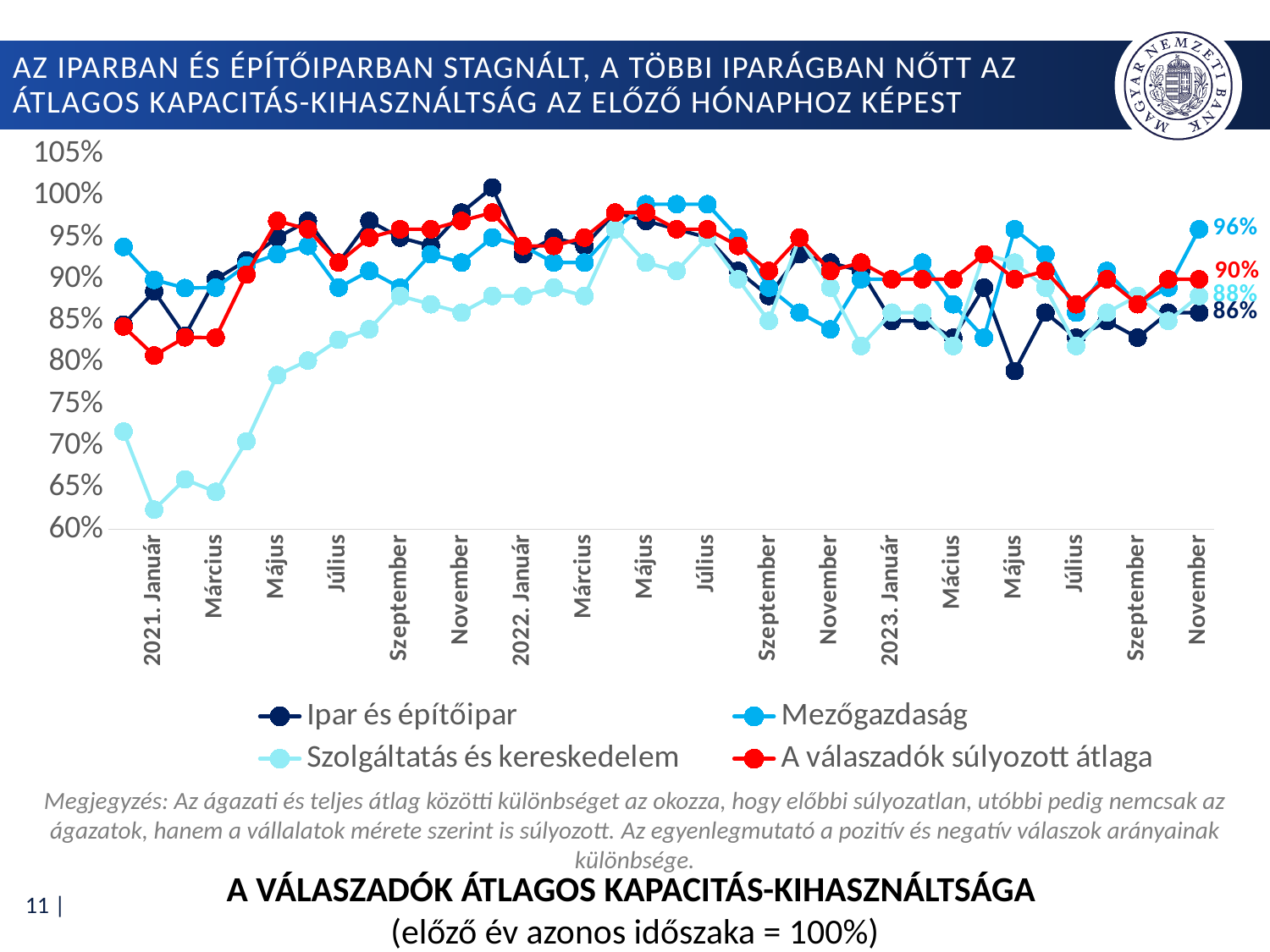
Is the value for Szolgáltatás és kereskedelem in 2021. Január greater or less than 75%? less How many series does the legend list? 4 What is the value for A válaszadók súlyozott átlaga at the last point (November 2023)? 90% What is the difference between the Mezőgazdaság and Ipar és építőipar values at the last point (November 2023)? 10 percentage points What is the value for Mezőgazdaság at the last point (November 2023)? 96% What is the value for Szolgáltatás és kereskedelem at the last point (November 2023)? 88% Does the Szolgáltatás és kereskedelem series rise or fall from 2021. Január to November 2021? rise What kind of chart is shown on the slide? line chart What is the value for Ipar és építőipar at the last point (November 2023)? 86% Which series has the highest value at the last point (November 2023)? Mezőgazdaság Which series has the larger value in 2021. Január: Mezőgazdaság or Szolgáltatás és kereskedelem? Mezőgazdaság Which series has the lowest value at the last point (November 2023)? Ipar és építőipar